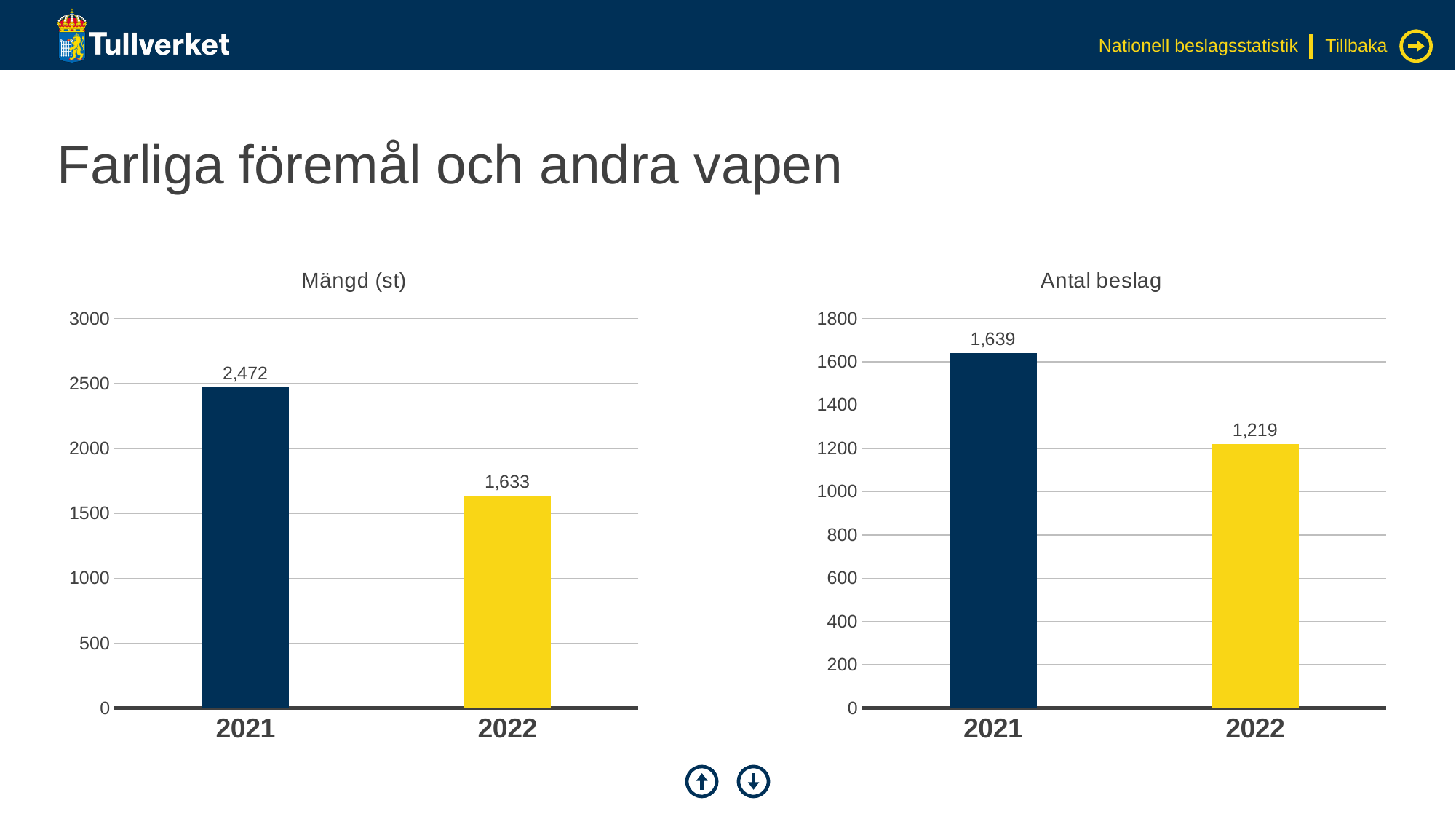
In the 'Antal beslag' chart, which year has the lowest value? 2022 In the 'Antal beslag' chart, what is the difference between the 2021 and 2022 values? 420 In the 'Mängd (st)' chart, do the values rise or fall from 2021 to 2022? Fall In the 'Antal beslag' chart, what is the value for 2021? 1,639 What kind of chart is the 'Antal beslag' chart? Bar chart In the 'Mängd (st)' chart, how many years are shown on the x axis? 2 In the 'Antal beslag' chart, what is the value for 2022? 1,219 In the 'Mängd (st)' chart, what is the difference between the 2021 and 2022 values? 839 In the 'Antal beslag' chart, is the value for 2021 greater or less than 1600? greater In the 'Mängd (st)' chart, which year has the highest value? 2021 In the 'Mängd (st)' chart, what is the value for 2022? 1,633 In the 'Mängd (st)' chart, what is the value for 2021? 2,472